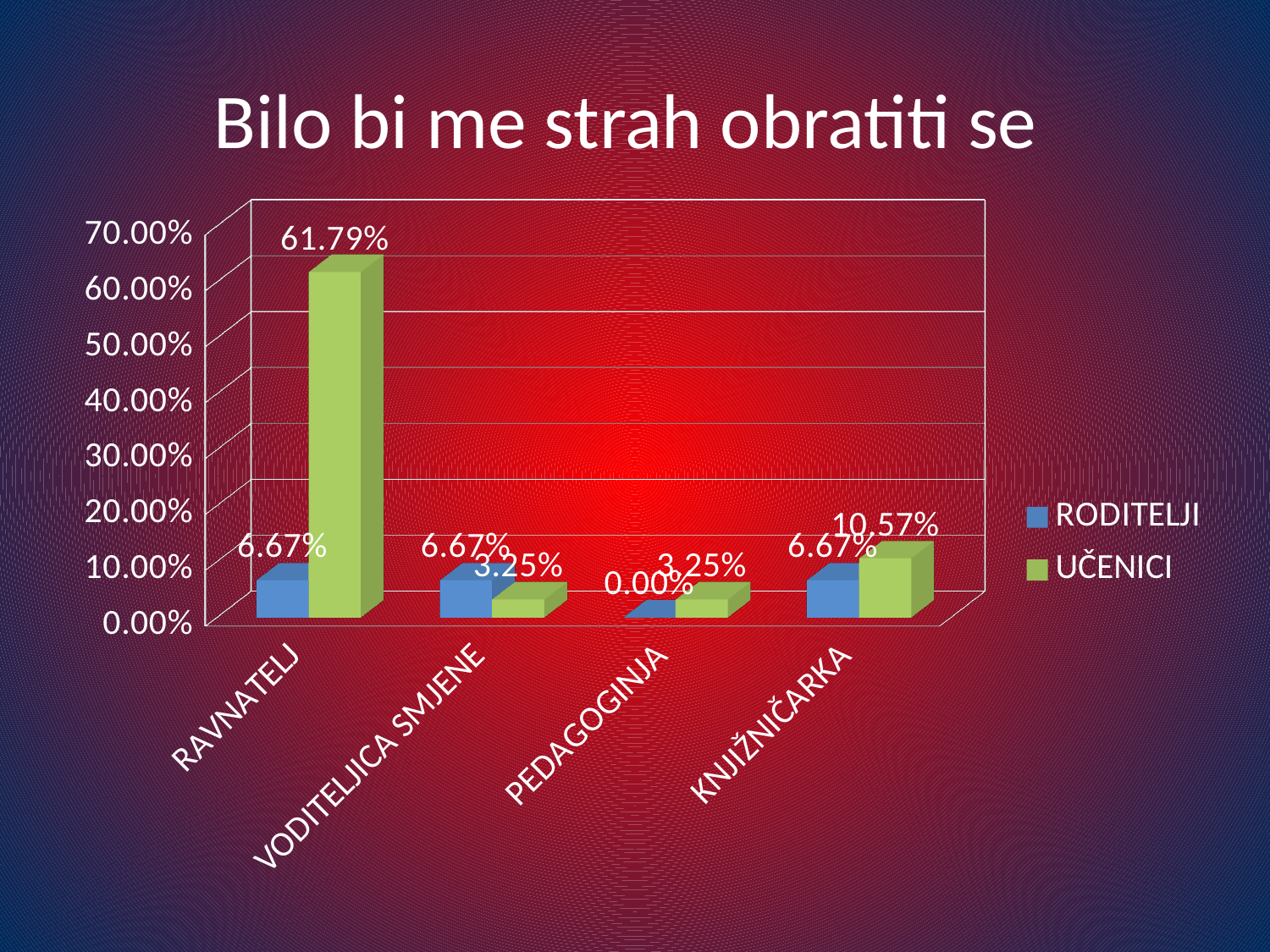
What is the value for RODITELJI for PEDAGOGINJA? 0.00% What kind of chart is shown on the slide? bar chart What is the difference between the UČENICI value for RAVNATELJ and the UČENICI value for KNJIŽNIČARKA? 51.22% What is the value for UČENICI for RAVNATELJ? 61.79% What is the value for UČENICI for VODITELJICA SMJENE? 3.25% Which category has the highest UČENICI value? RAVNATELJ What is the value for UČENICI for KNJIŽNIČARKA? 10.57% For KNJIŽNIČARKA, which series has the larger value, RODITELJI or UČENICI? UČENICI Which category has the lowest RODITELJI value? PEDAGOGINJA How many categories are shown on the x axis? 4 How many series does the legend list? 2 What is the title of the chart? Bilo bi me strah obratiti se